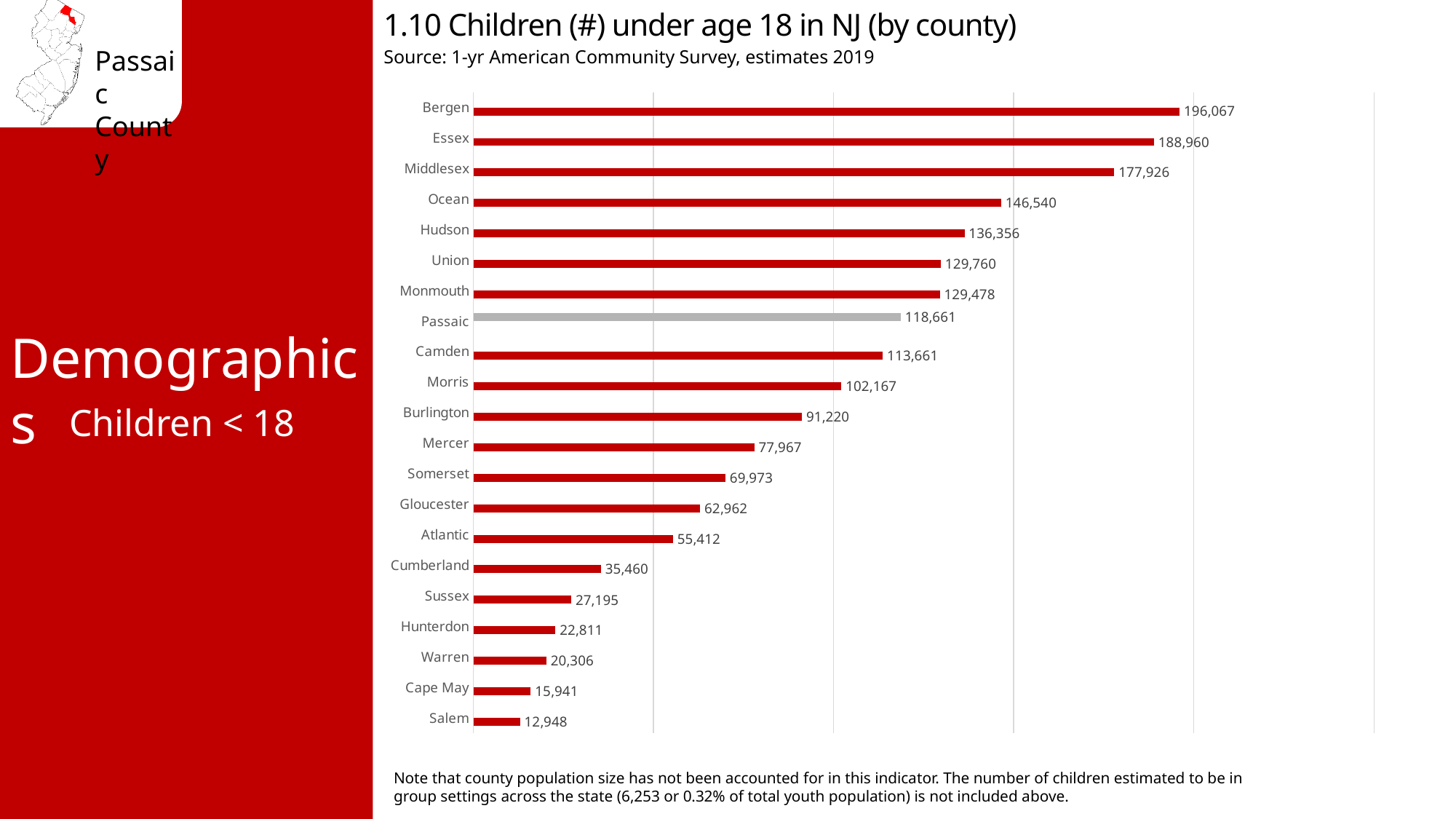
Which county has more children under age 18, Sussex or Warren? Sussex What is the difference between the number of children under 18 in Passaic County and Camden County? 5,000 Which county's bar is shown in grey instead of red? Passaic Which county has the highest number of children under age 18? Bergen How many counties are shown in the chart? 21 Which county has more children under age 18, Hudson or Morris? Hudson What is the number of children under age 18 in Passaic County? 118,661 How many more children under age 18 does Bergen County have than Passaic County? 77,406 What is the number of children under age 18 in Ocean County? 146,540 Which county has the lowest number of children under age 18? Salem What is the number of children under age 18 in Cumberland County? 35,460 What type of chart is used to show children under age 18 by county? Bar chart